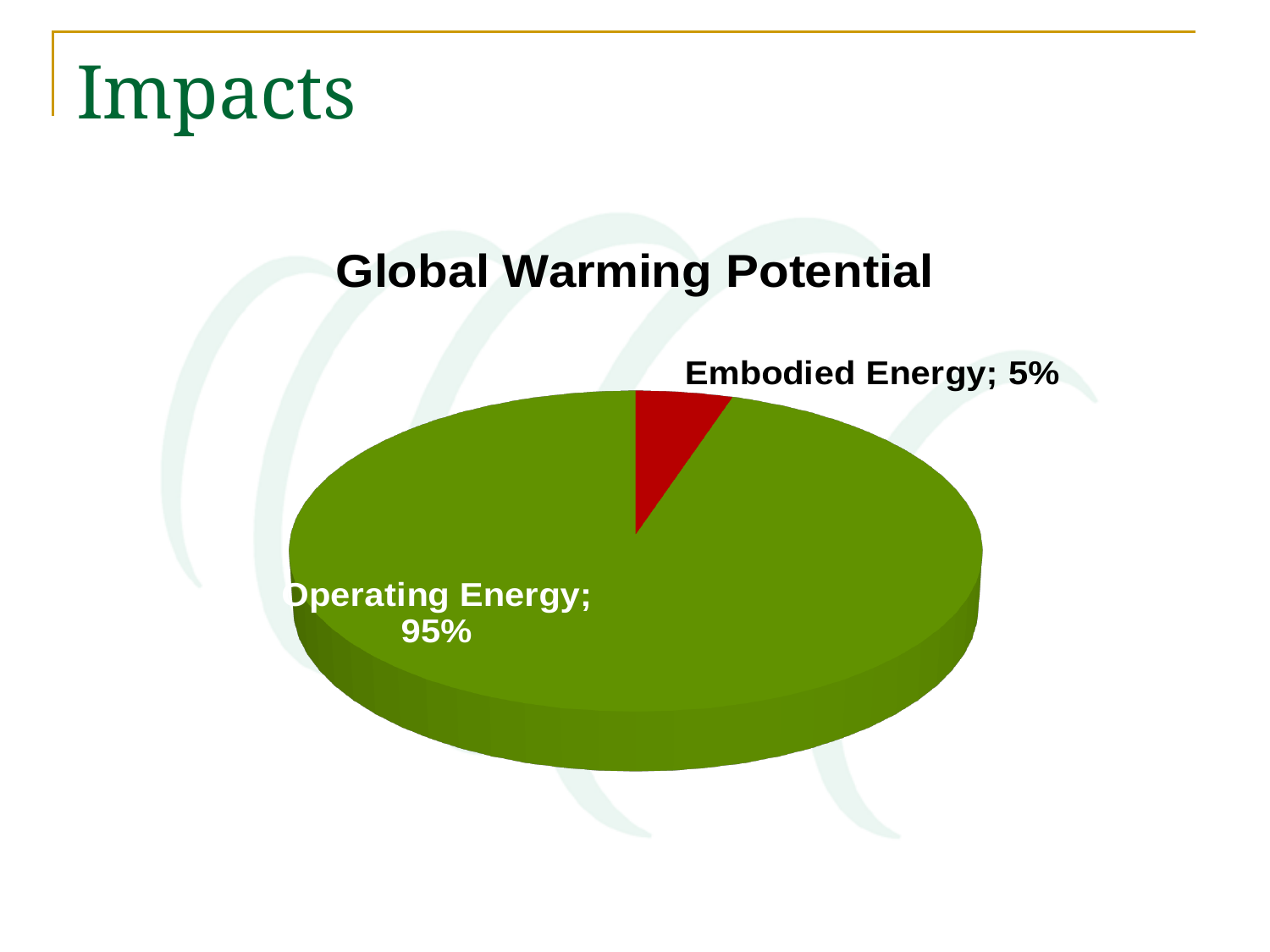
What share of the pie does Embodied Energy represent? 5% What is the title of the chart? Global Warming Potential What kind of chart is shown on the slide? Pie chart How many slices does the pie chart have? 2 Which category has the smallest slice of the pie? Embodied Energy What is the total of the two slices shown in the pie chart? 100% Which category has the largest slice of the pie? Operating Energy Which is larger, the Embodied Energy slice or the Operating Energy slice? Operating Energy What share of the pie does Operating Energy represent? 95% What colour is the Embodied Energy slice? Red What is the difference in percentage points between Operating Energy and Embodied Energy? 90 percentage points